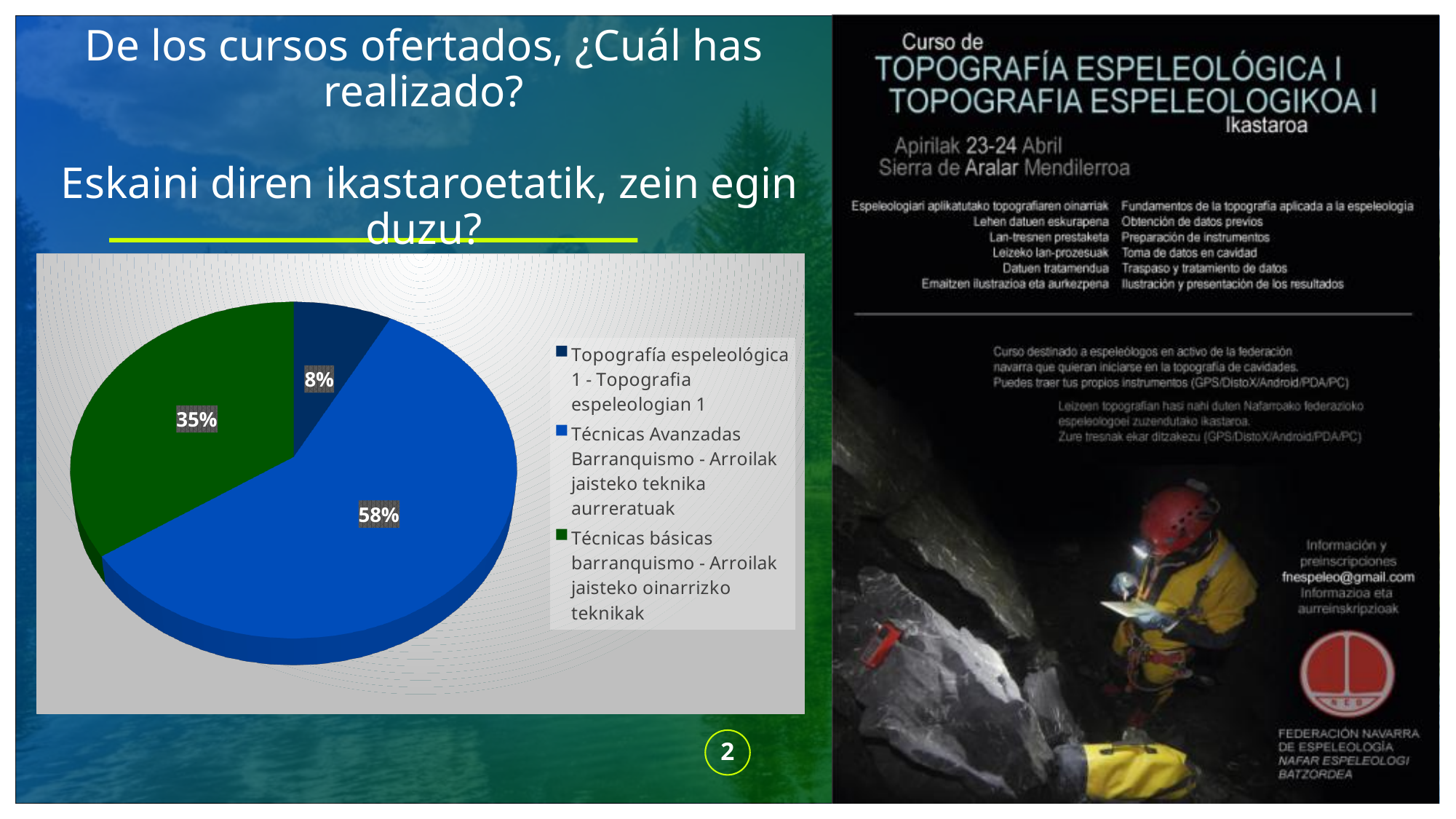
Which course has the largest slice of the pie? Técnicas Avanzadas Barranquismo - Arroilak jaisteko teknika aurreratuak What share of the pie does "Técnicas básicas barranquismo - Arroilak jaisteko oinarrizko teknikak" have? 35% What kind of chart is shown on the slide? pie chart What colour is the slice for "Técnicas básicas barranquismo - Arroilak jaisteko oinarrizko teknikak"? green What share of the pie does "Técnicas Avanzadas Barranquismo - Arroilak jaisteko teknika aurreratuak" have? 58% What is the difference in percentage points between the "Técnicas básicas barranquismo" slice and the "Topografía espeleológica 1" slice? 27 How many entries does the legend list? 3 How many slices does the pie chart have? 3 What share of the pie does "Topografía espeleológica 1 - Topografia espeleologian 1" have? 8% Which course has the smallest slice of the pie? Topografía espeleológica 1 - Topografia espeleologian 1 Which is larger: the slice for "Técnicas básicas barranquismo" or the slice for "Topografía espeleológica 1"? Técnicas básicas barranquismo What is the difference in percentage points between the "Técnicas Avanzadas Barranquismo" slice and the "Técnicas básicas barranquismo" slice? 23